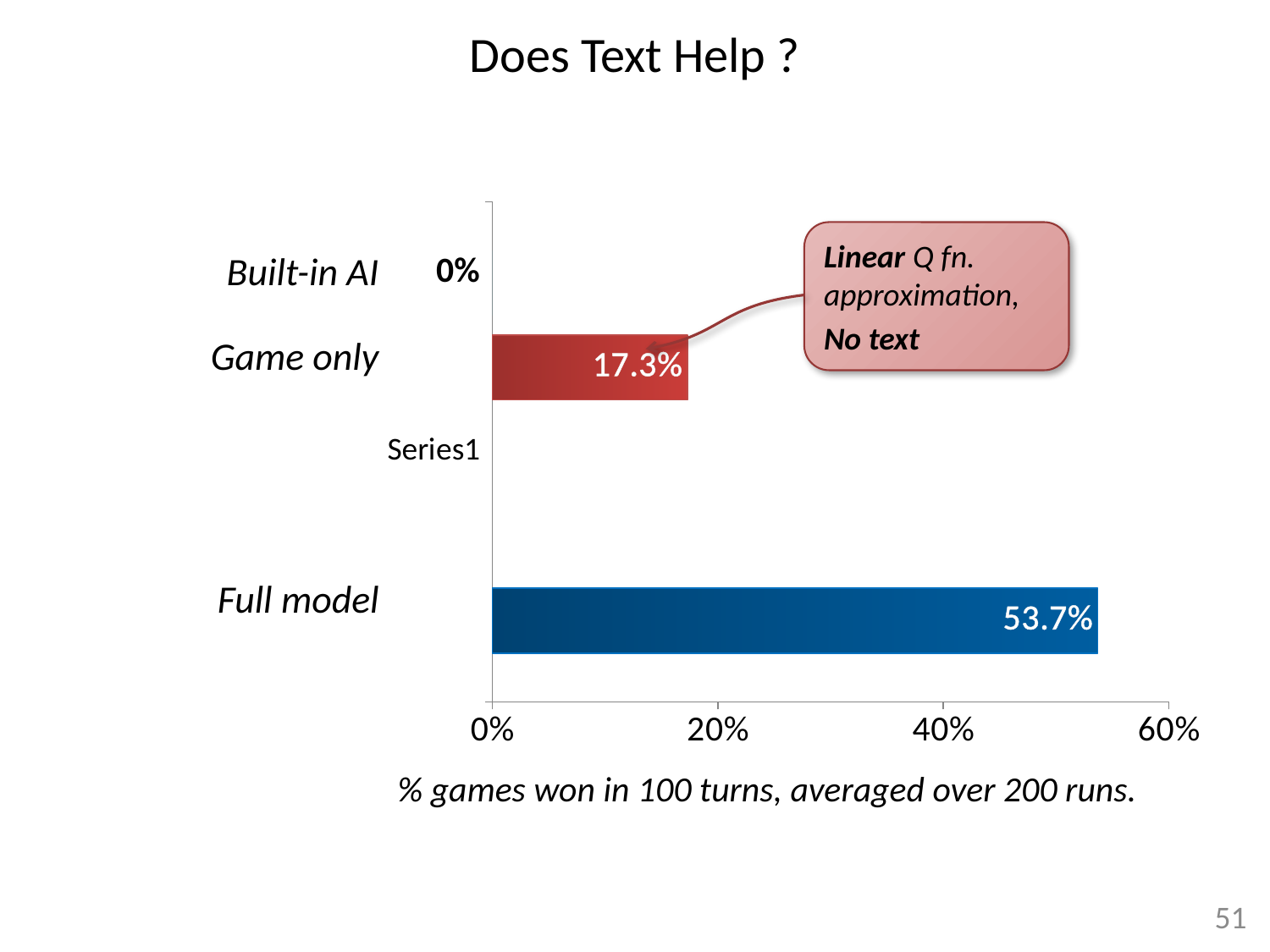
Is the value for Game only greater or less than 20%? less Which category has the highest value? Full model Is the value for Full model greater or less than 40%? greater What is the title of the slide? Does Text Help ? Which category has the lowest value? Built-in AI What is the value for Built-in AI? 0% What kind of chart is shown on the slide? bar chart What is the value for Game only? 17.3% What is the highest value shown on the x axis? 60% Which is larger, the value for Game only or the value for Full model? Full model What is the difference between the values for Full model and Game only? 36.4% What is the value for Full model? 53.7%